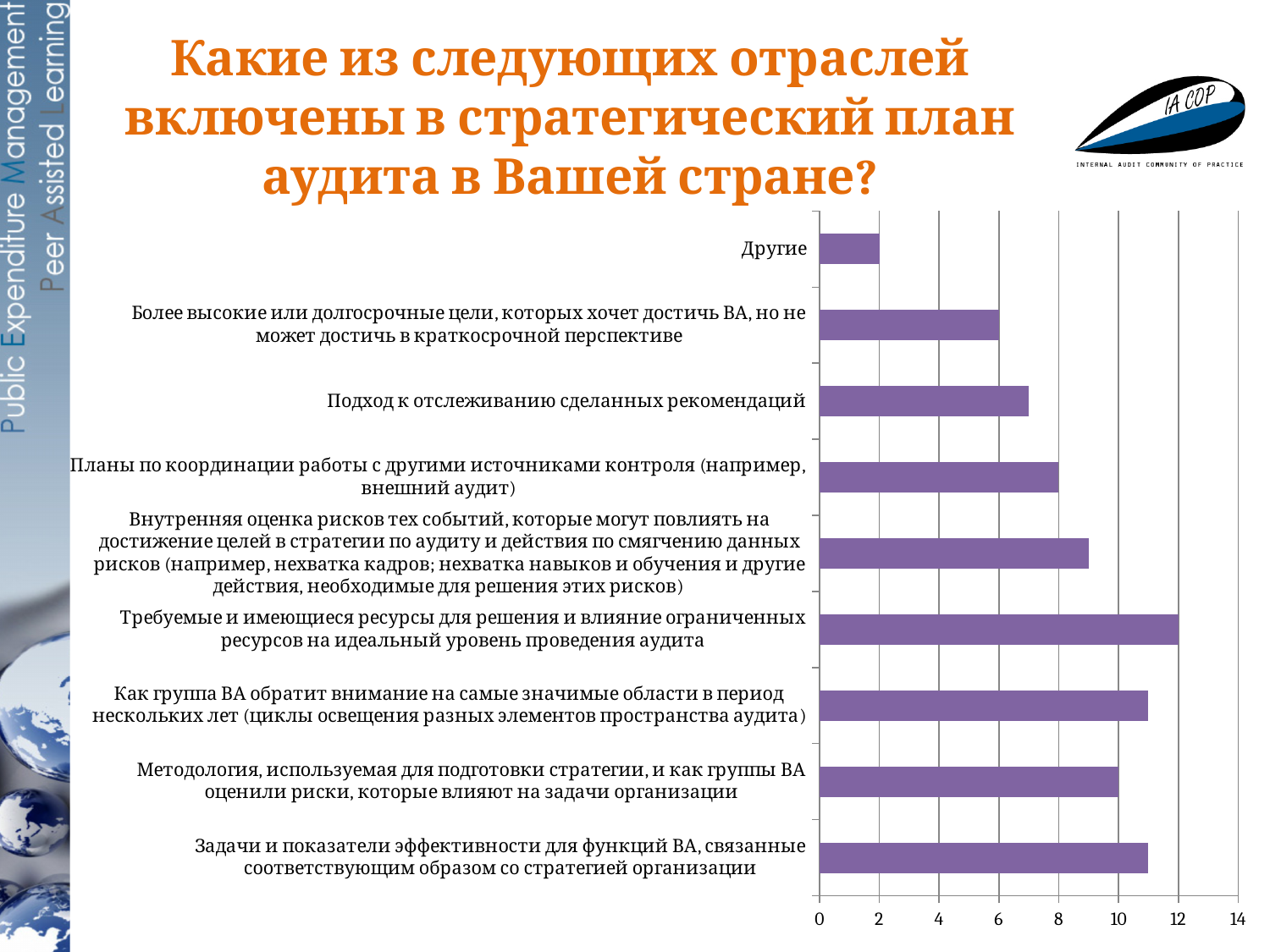
What is the value for 'Другие'? 2 What type of chart is shown on the slide? Bar chart What is the difference between the value for 'Требуемые и имеющиеся ресурсы...' and the value for 'Другие'? 10 Is the value for 'Внутренняя оценка рисков тех событий...' greater or less than 8? greater What is the value for 'Методология, используемая для подготовки стратегии, и как группы ВА оценили риски, которые влияют на задачи организации'? 10 What is the value for 'Планы по координации работы с другими источниками контроля (например, внешний аудит)'? 8 How many categories are plotted in the chart? 9 Which category has the lowest value in the chart? Другие Which is larger: the value for 'Методология, используемая для подготовки стратегии...' or the value for 'Более высокие или долгосрочные цели...'? Методология, используемая для подготовки стратегии... What is the value for 'Требуемые и имеющиеся ресурсы для решения и влияние ограниченных ресурсов на идеальный уровень проведения аудита'? 12 Which category has the highest value in the chart? Требуемые и имеющиеся ресурсы для решения и влияние ограниченных ресурсов на идеальный уровень проведения аудита Is the value for 'Подход к отслеживанию сделанных рекомендаций' greater or less than 6? greater